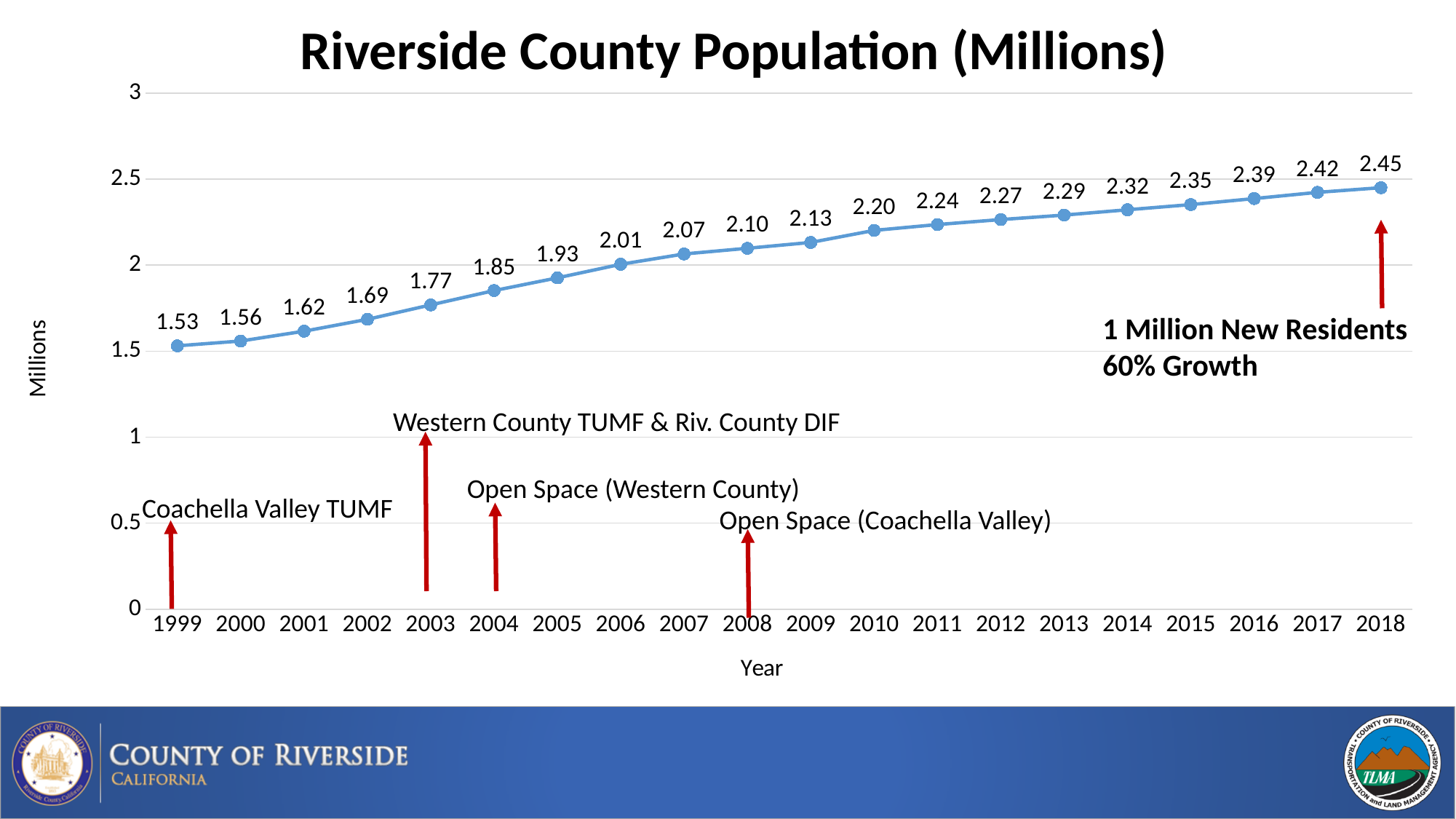
What is the difference between the population values for 2018 and 1999? 0.92 What is the population value shown for 2010? 2.20 Do the population values rise or fall from 1999 to 2018? Rise What is the population value shown for 1999? 1.53 Is the value for 2006 greater or less than 2? greater Which year has a larger population value, 2003 or 2012? 2012 Which year has the highest population value on the chart? 2018 What kind of chart is shown on the slide? Line chart What is the population value shown for 2005? 1.93 What is the title of the chart? Riverside County Population (Millions) Which year has the lowest population value on the chart? 1999 How many years are plotted on the x axis? 20